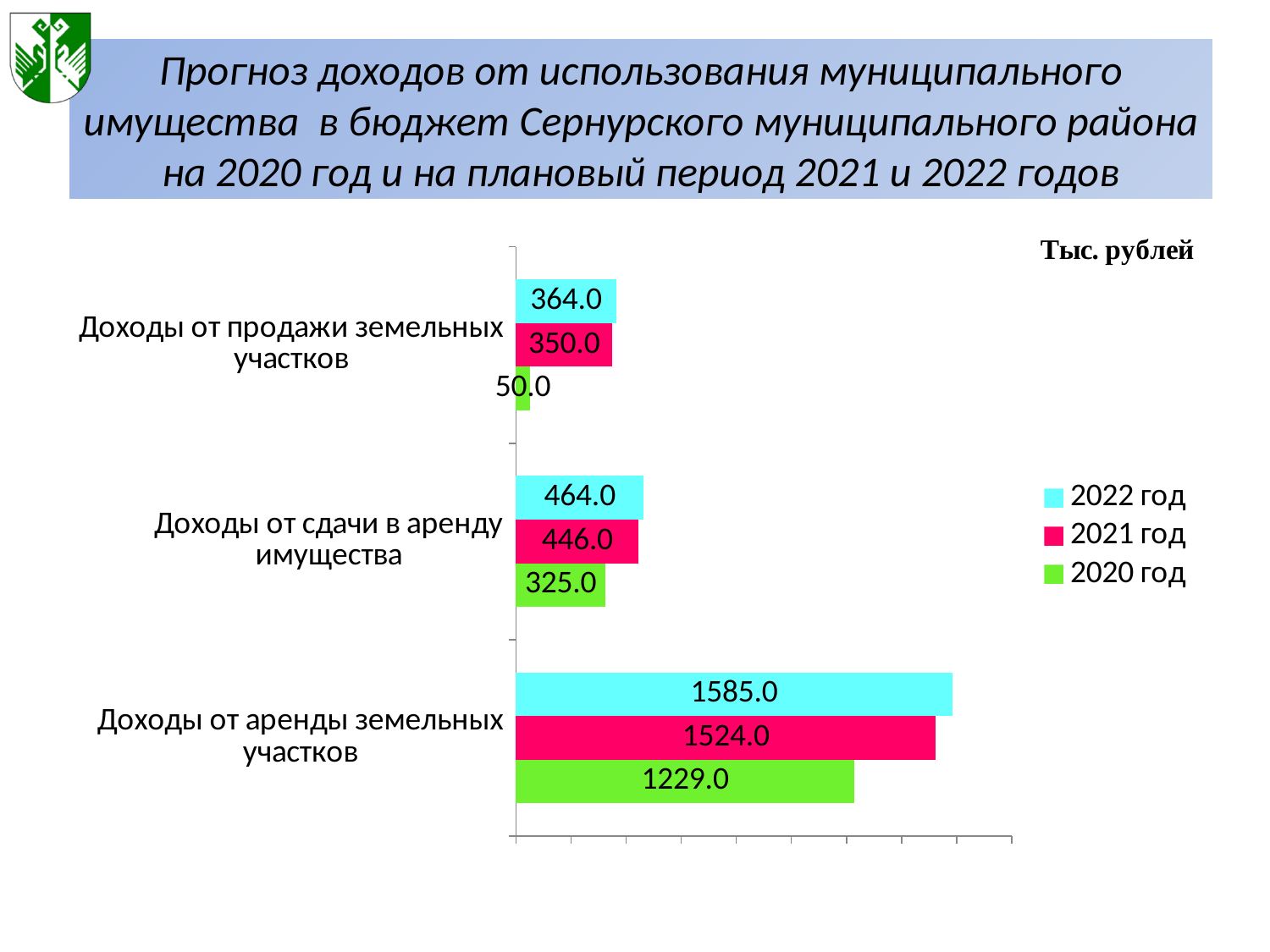
What is the difference between the 2021 год and 2020 год values for 'Доходы от продажи земельных участков'? 300.0 What is the value for 'Доходы от аренды земельных участков' in 2022 год? 1585.0 What unit is indicated in the top right corner of the chart? Тыс. рублей Which is larger for 'Доходы от сдачи в аренду имущества': the 2022 год value or the 2021 год value? 2022 год How many series does the legend list? 3 Which category has the highest value in 2021 год? Доходы от аренды земельных участков What is the value for 'Доходы от продажи земельных участков' in 2021 год? 350.0 What kind of chart is shown on the slide? bar chart What is the value for 'Доходы от сдачи в аренду имущества' in 2020 год? 325.0 What is the difference between the 2022 год and 2020 год values for 'Доходы от аренды земельных участков'? 356.0 Which category has the lowest value in 2020 год? Доходы от продажи земельных участков How many categories are shown on the chart? 3